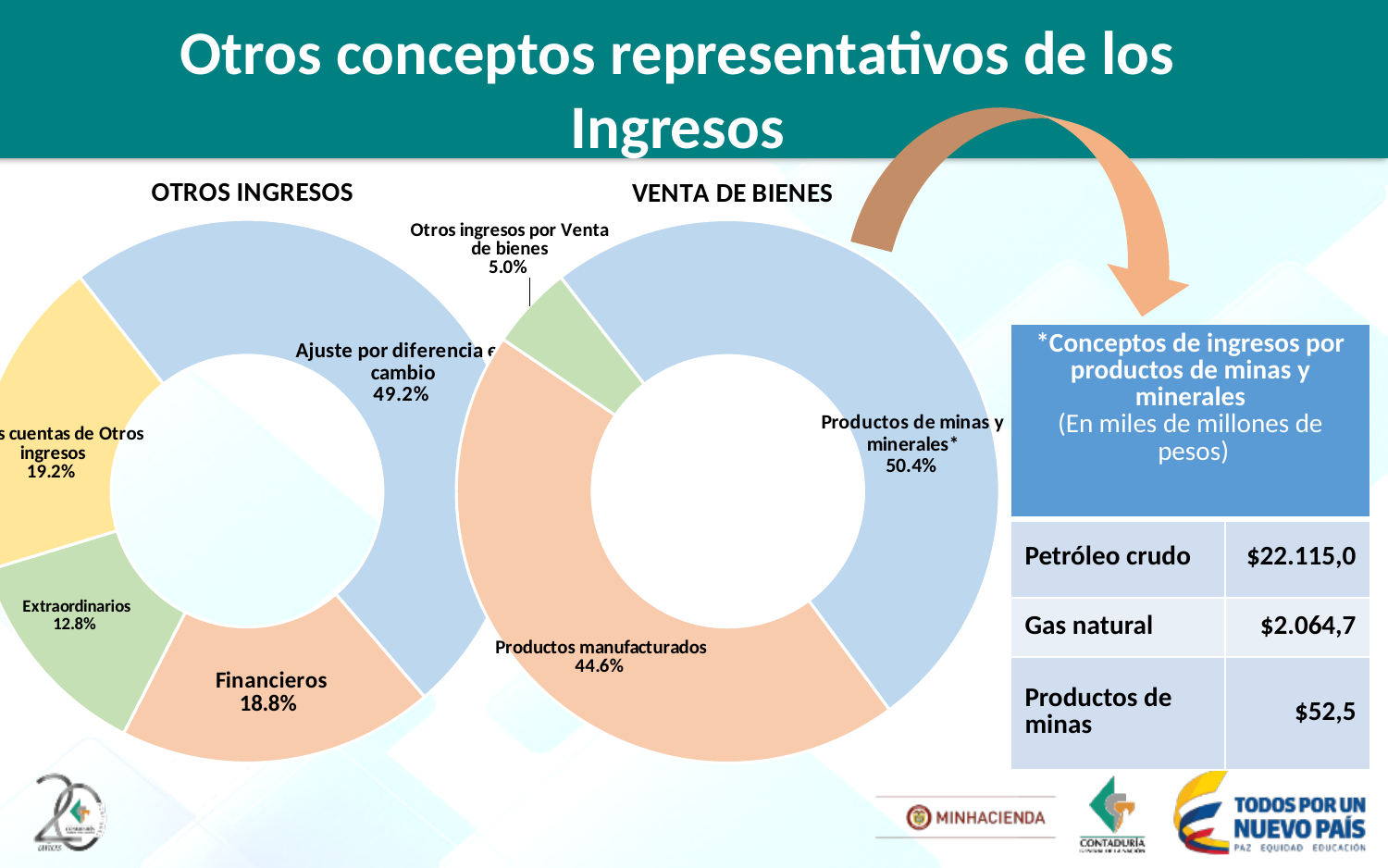
How many slices does the VENTA DE BIENES chart have? 3 In the OTROS INGRESOS chart, which category has the smallest share? Extraordinarios In the VENTA DE BIENES chart, which is larger: Productos de minas y minerales or Productos manufacturados? Productos de minas y minerales In the OTROS INGRESOS chart, what share is labelled for Extraordinarios? 12.8% In the VENTA DE BIENES chart, what share is labelled for Productos manufacturados? 44.6% What type of chart is the VENTA DE BIENES chart? Donut (pie) chart In the VENTA DE BIENES chart, what share is labelled for Productos de minas y minerales? 50.4% In the OTROS INGRESOS chart, what share is labelled for Ajuste por diferencia en cambio? 49.2% In the VENTA DE BIENES chart, which category has the smallest share? Otros ingresos por Venta de bienes In the OTROS INGRESOS chart, which category has the largest share? Ajuste por diferencia en cambio In the OTROS INGRESOS chart, what is the difference in percentage points between Financieros and Extraordinarios? 6.0 In the OTROS INGRESOS chart, what share is labelled for Financieros? 18.8%